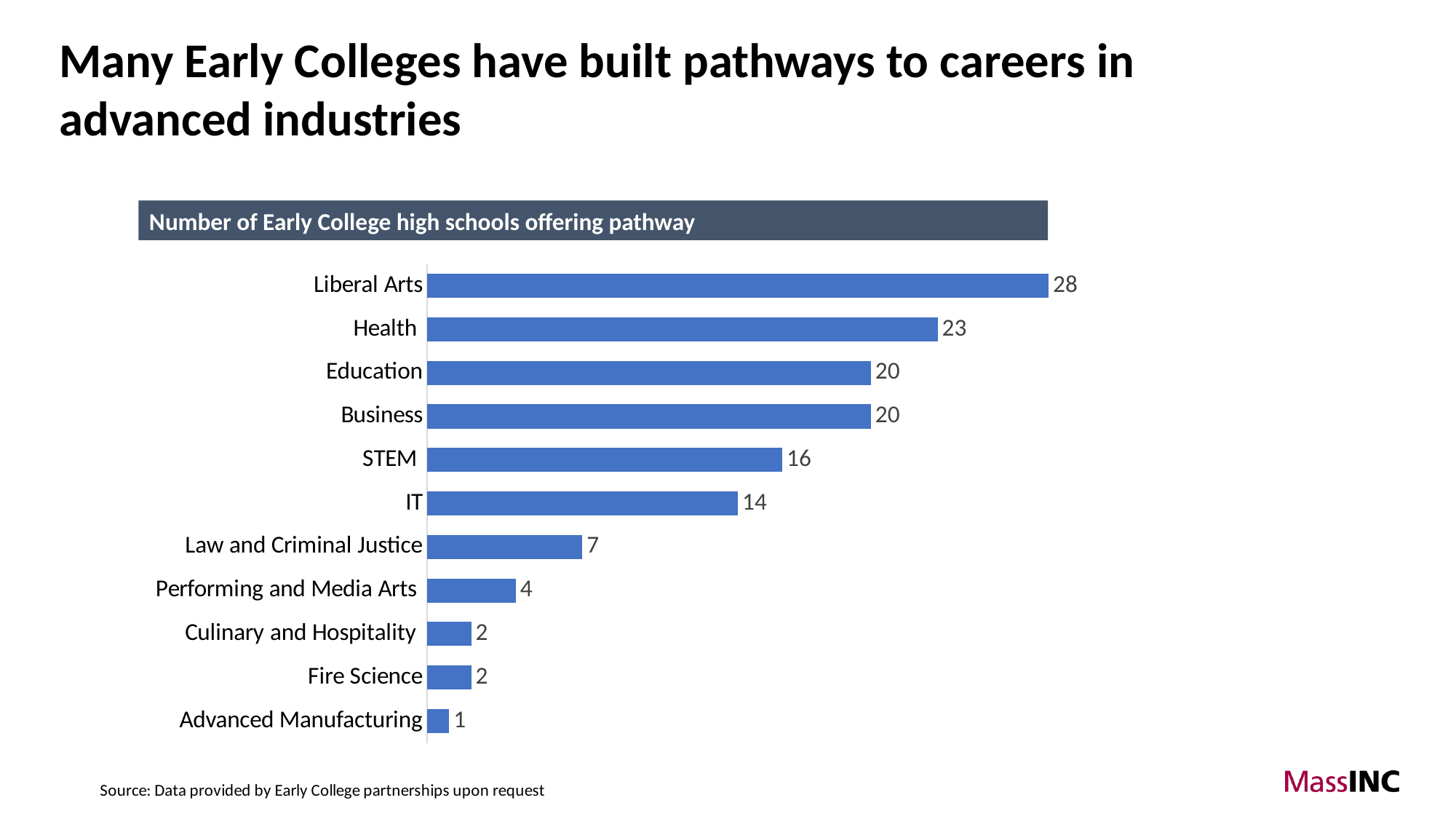
What is the value shown for STEM? 16 What is the difference between the values for Liberal Arts and Health? 5 What is the difference between the values for IT and Performing and Media Arts? 10 What kind of chart is shown on the slide? Bar chart Which two pathways both have a value of 20? Education and Business How many Early College high schools offer the Health pathway? 23 Which has a higher value, STEM or IT? STEM What is the title of the chart? Number of Early College high schools offering pathway Which pathway is offered by the fewest Early College high schools? Advanced Manufacturing How many Early College high schools offer the Law and Criminal Justice pathway? 7 How many pathway categories are shown in the chart? 11 Which pathway is offered by the most Early College high schools? Liberal Arts